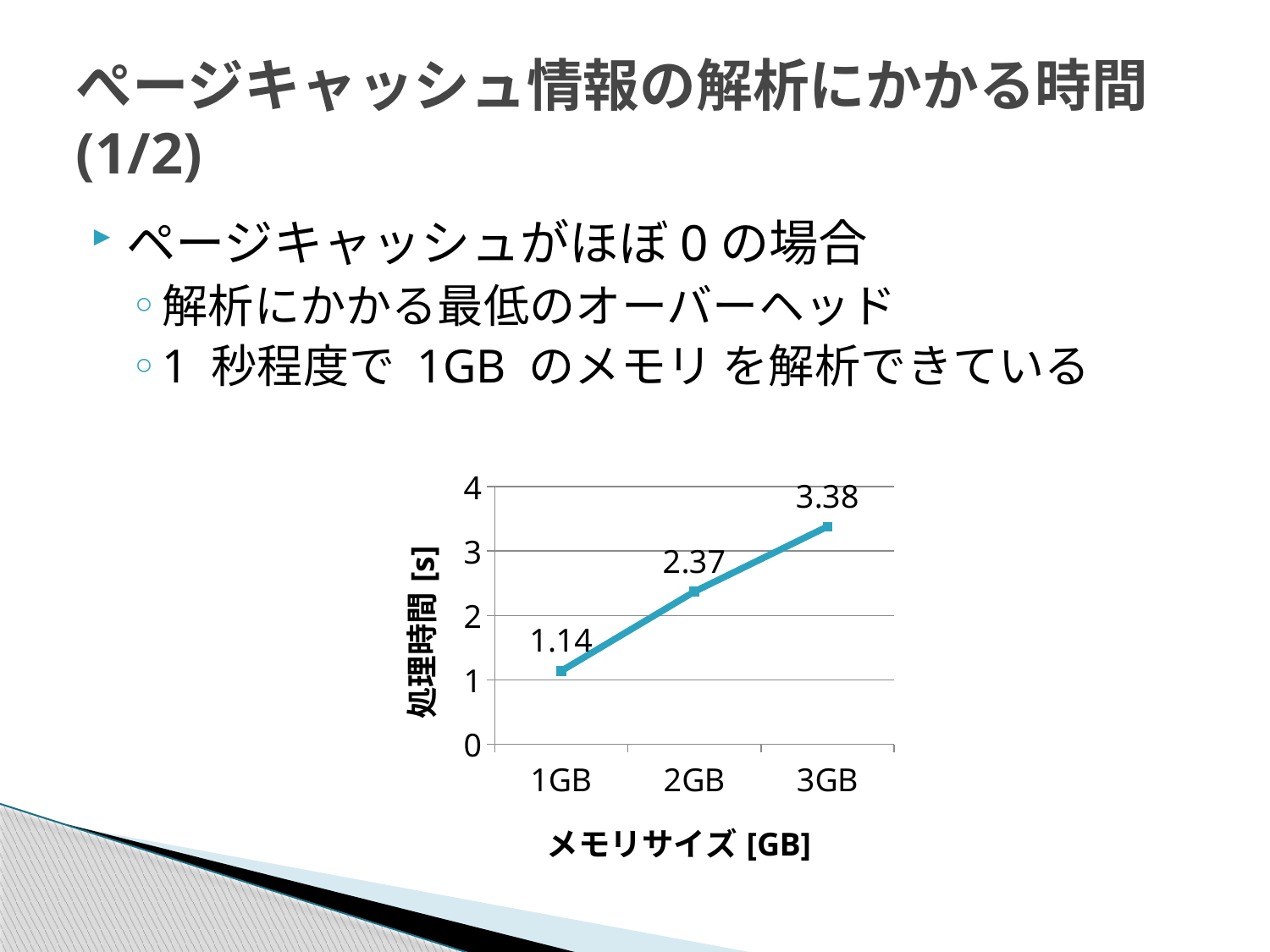
What kind of chart is shown on the slide? line chart Which memory size has the lowest processing time? 1GB What is the difference in processing time between 3GB and 1GB? 2.24 What is the processing time for 3GB of memory? 3.38 What is the difference in processing time between 2GB and 1GB? 1.23 Which memory size has the highest processing time? 3GB Is the processing time for 3GB greater or less than 3? greater Which has a larger processing time, 2GB or 3GB? 3GB What is the processing time for 1GB of memory? 1.14 What is the processing time for 2GB of memory? 2.37 Does the processing time rise or fall as memory size increases? rise How many memory sizes are plotted on the chart? 3